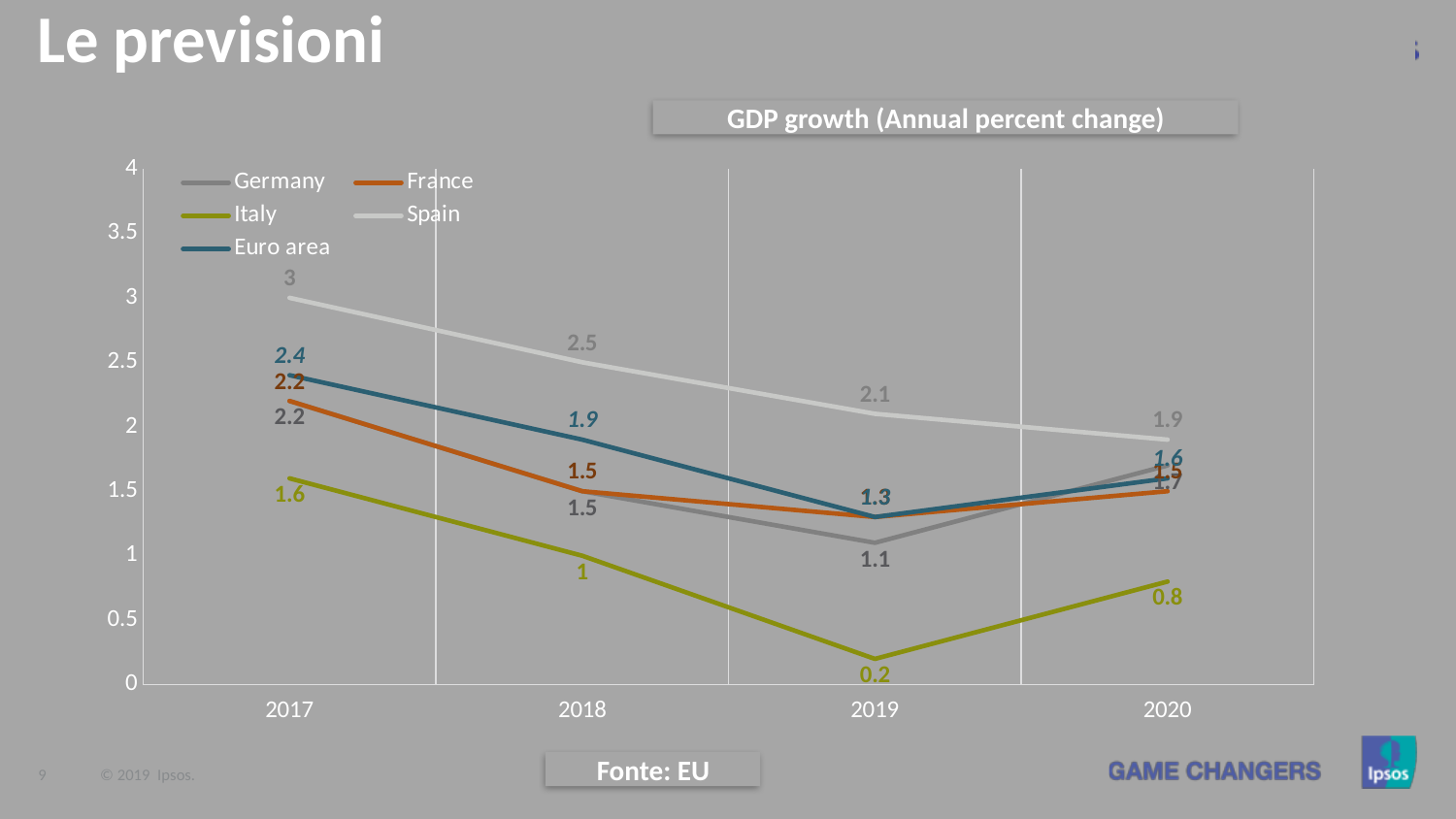
How many series does the legend list? 5 Which country has the highest GDP growth in 2018? Spain How many years are shown on the x axis? 4 Which country has the lowest GDP growth in 2020? Italy What is the GDP growth value for Germany in 2019? 1.1 What kind of chart is shown on the slide? line chart What is the GDP growth value for Italy in 2019? 0.2 Does Spain's GDP growth rise or fall from 2017 to 2020? fall What is the GDP growth value for the Euro area in 2017? 2.4 What is the difference between Spain's GDP growth in 2017 and in 2020? 1.1 What is the title of the chart? GDP growth (Annual percent change) What is the GDP growth value for Spain in 2017? 3